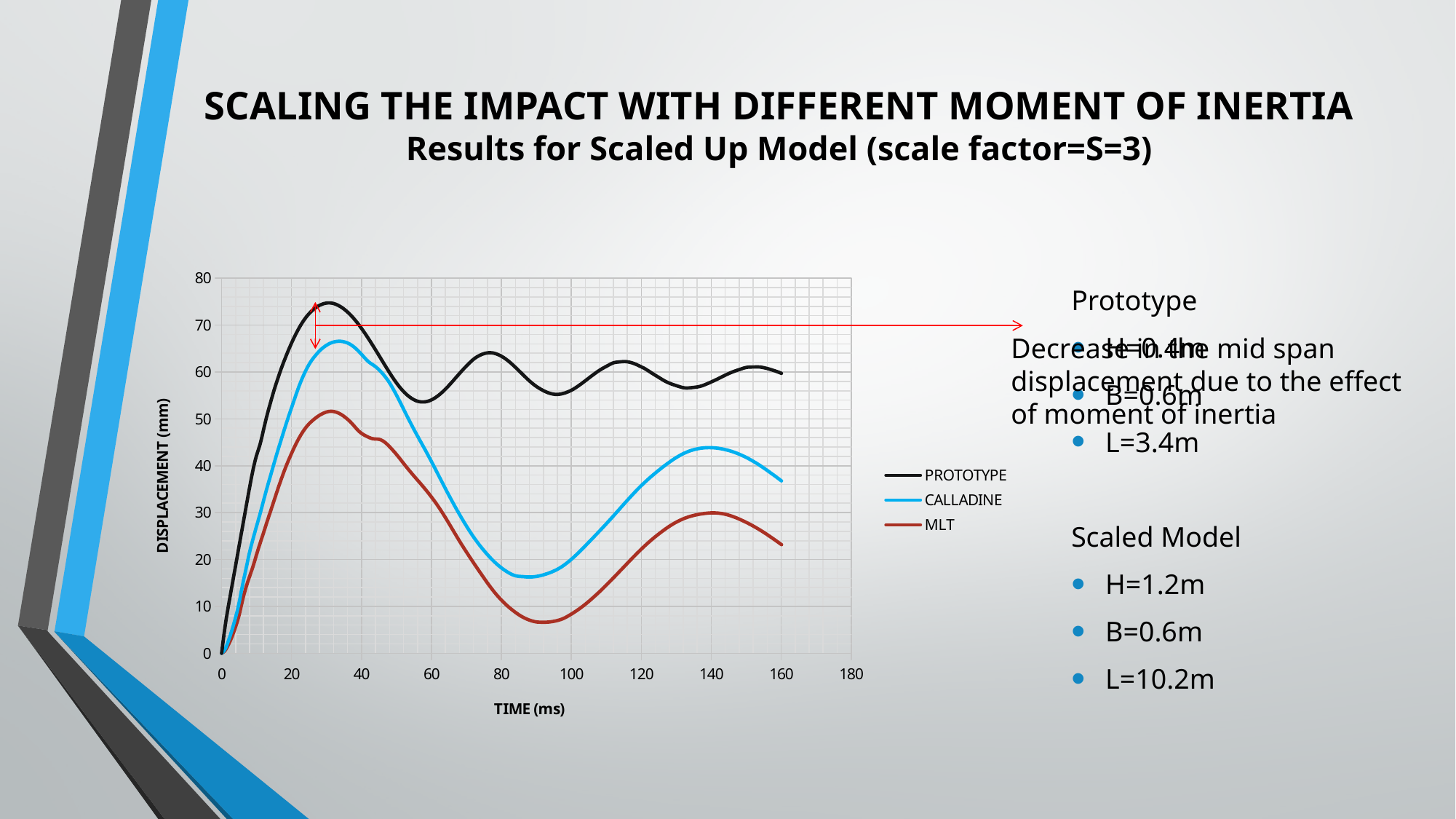
Is the peak displacement of the MLT series greater or less than 40? greater What is the label of the chart's vertical axis? DISPLACEMENT (mm) What are the three series named in the chart legend? PROTOTYPE, CALLADINE, MLT At 100 ms, which series has the larger displacement, PROTOTYPE or MLT? PROTOTYPE Is the displacement of the CALLADINE series at 160 ms greater or less than 40? less Between 40 ms and 90 ms, does the MLT series rise or fall? fall How many series does the chart legend list? 3 Is the lowest displacement of the MLT series (around 90 ms) greater or less than 10? less Which series has the lowest peak displacement? MLT What kind of chart is shown on the slide? line chart Which series reaches the highest peak displacement? PROTOTYPE